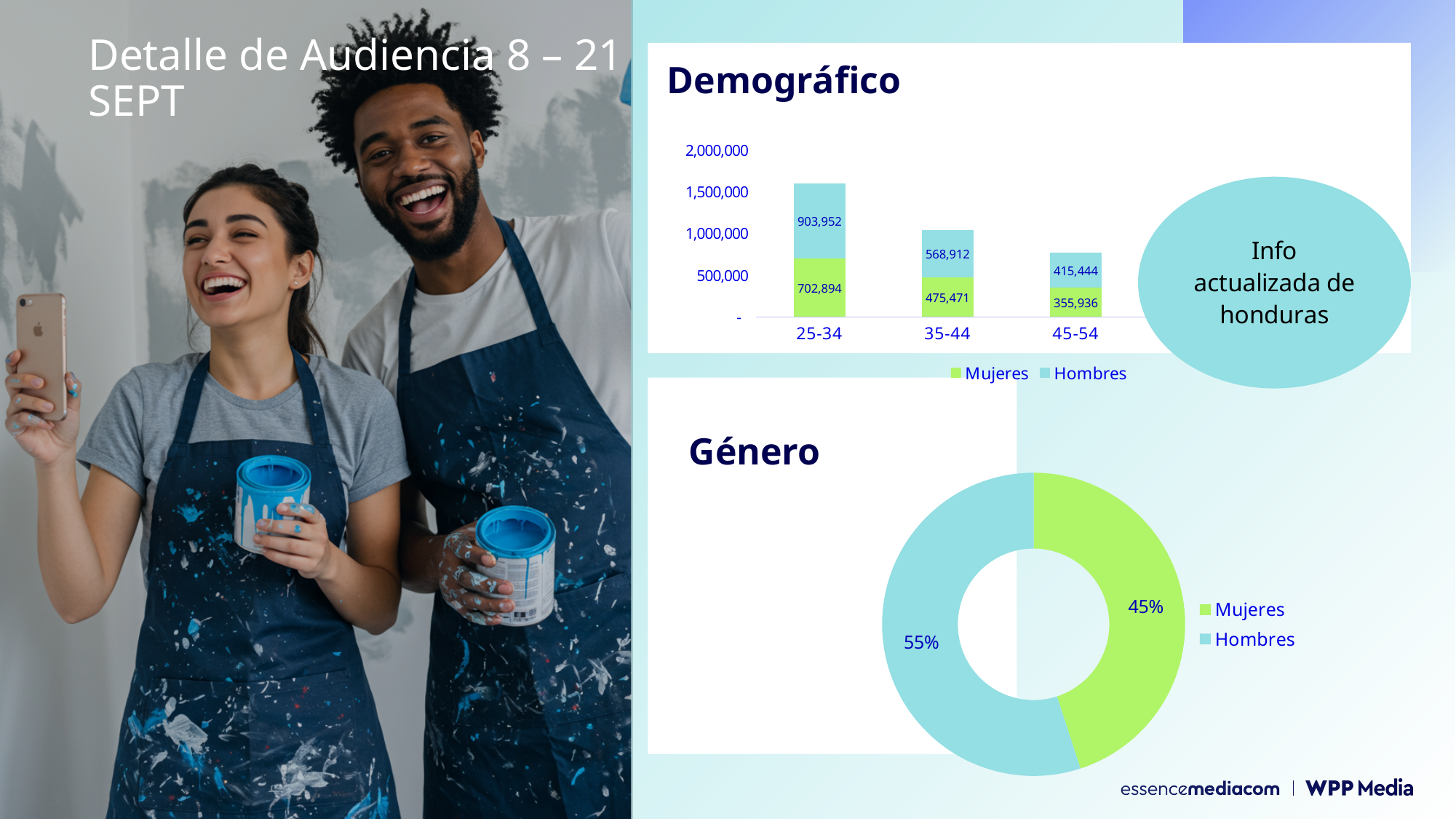
In the Demográfico chart, what is the difference between Hombres and Mujeres in the 25-34 age group? 201,058 In the Demográfico chart, which age group has the highest value for Hombres? 25-34 In the Demográfico chart, what is the value for Mujeres in the 35-44 age group? 475,471 In the Demográfico chart, what is the value for Hombres in the 25-34 age group? 903,952 What kind of chart is the Género chart? Donut chart In the Género chart, what share is Hombres? 55% In the Demográfico chart, which is larger in the 45-54 age group, Mujeres or Hombres? Hombres In the Demográfico chart, what is the value for Mujeres in the 45-54 age group? 355,936 In the Demográfico chart, what is the total of the stacked bar for the 35-44 age group? 1,044,383 How many series does the legend of the Demográfico chart list? 2